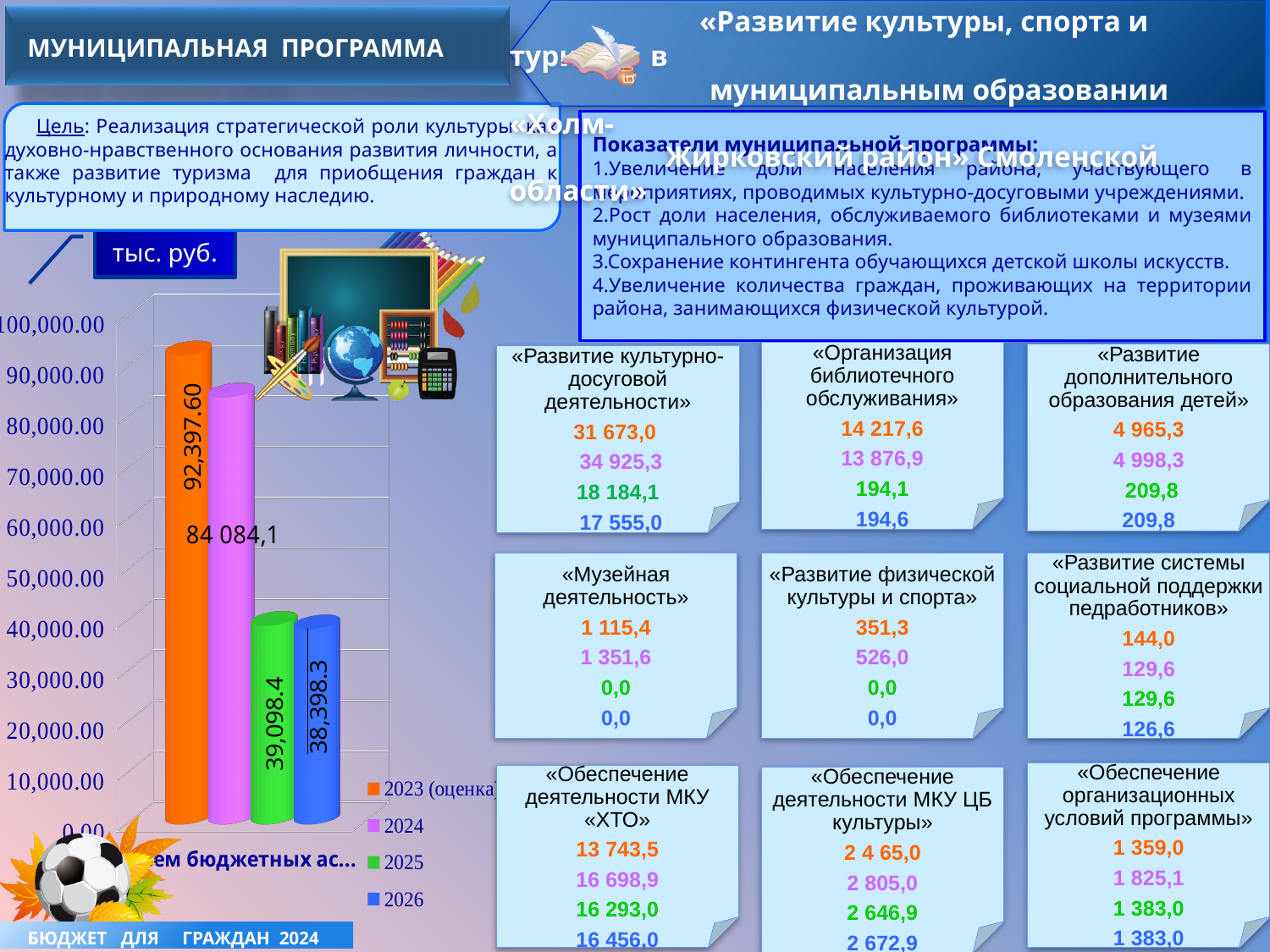
How many series does the chart legend list? 4 What is the value of the 2024 bar in the chart? 84 084,1 What is the value of the 2026 bar in the chart? 38,398.3 What is the value of the 2023 (оценка) bar in the chart? 92,397.60 Is the value for 2024 in the chart greater or less than 80,000.00? greater What unit is indicated for the values in the chart? тыс. руб. What kind of chart is shown on the left of the slide? bar chart Which year has the lowest bar in the chart? 2026 Which is larger in the chart, the value for 2025 or the value for 2026? 2025 What is the value of the 2025 bar in the chart? 39,098.4 Which year has the highest bar in the chart? 2023 (оценка) What is the difference between the 2023 (оценка) value and the 2024 value in the chart? 8,313.5